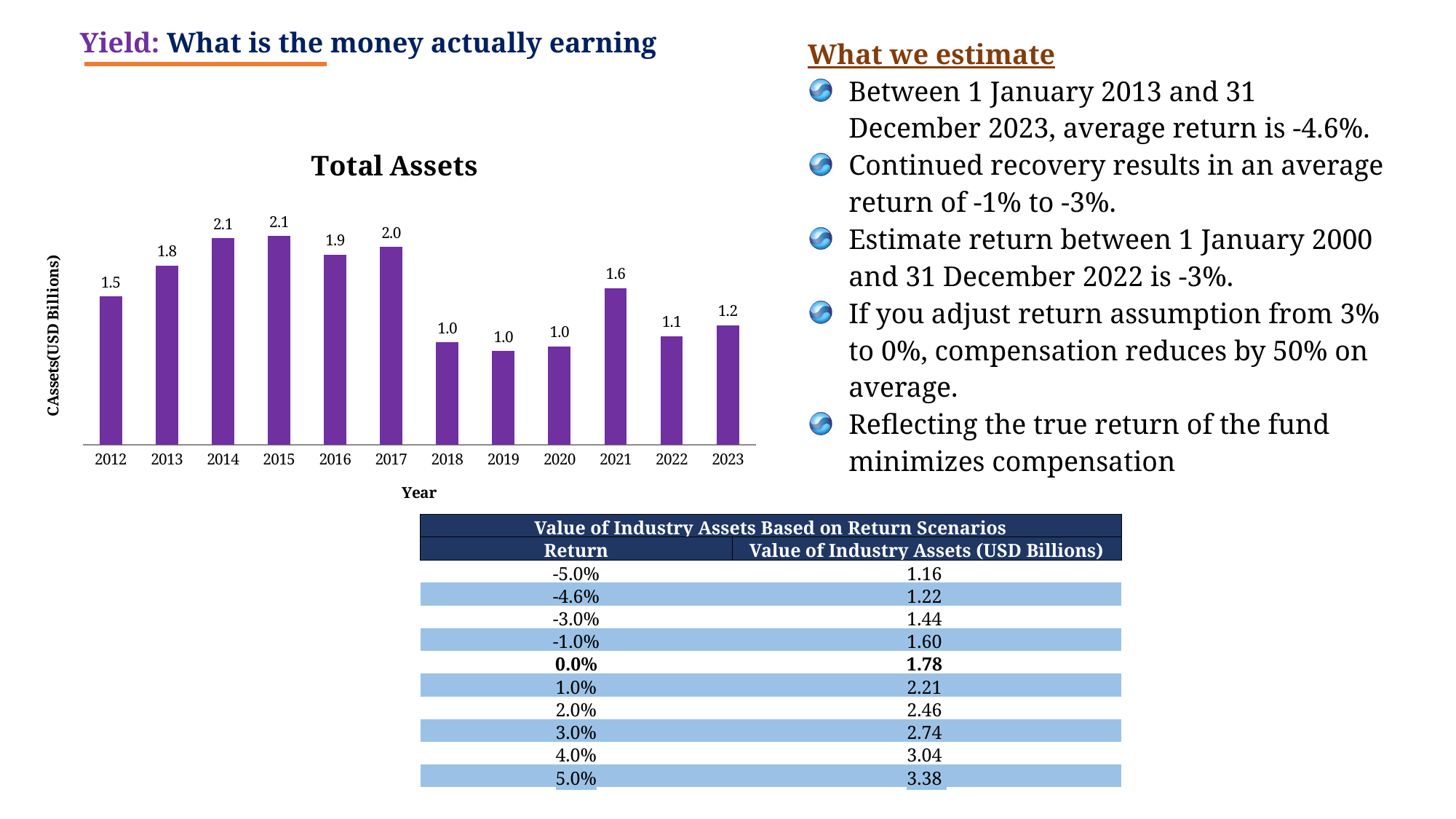
In the Total Assets chart, which is larger, the value for 2013 or the value for 2023? 2013 How many years are shown on the x axis of the Total Assets chart? 12 In the Total Assets chart, do the values rise or fall from 2017 to 2018? fall What is the value for 2023 in the Total Assets chart? 1.2 What is the value for 2021 in the Total Assets chart? 1.6 What is the x-axis label of the Total Assets chart? Year What is the value for 2017 in the Total Assets chart? 2.0 What is the difference between the values for 2015 and 2018 in the Total Assets chart? 1.1 What is the value for 2012 in the Total Assets chart? 1.5 What kind of chart is the Total Assets chart? bar chart What is the difference between the values for 2021 and 2022 in the Total Assets chart? 0.5